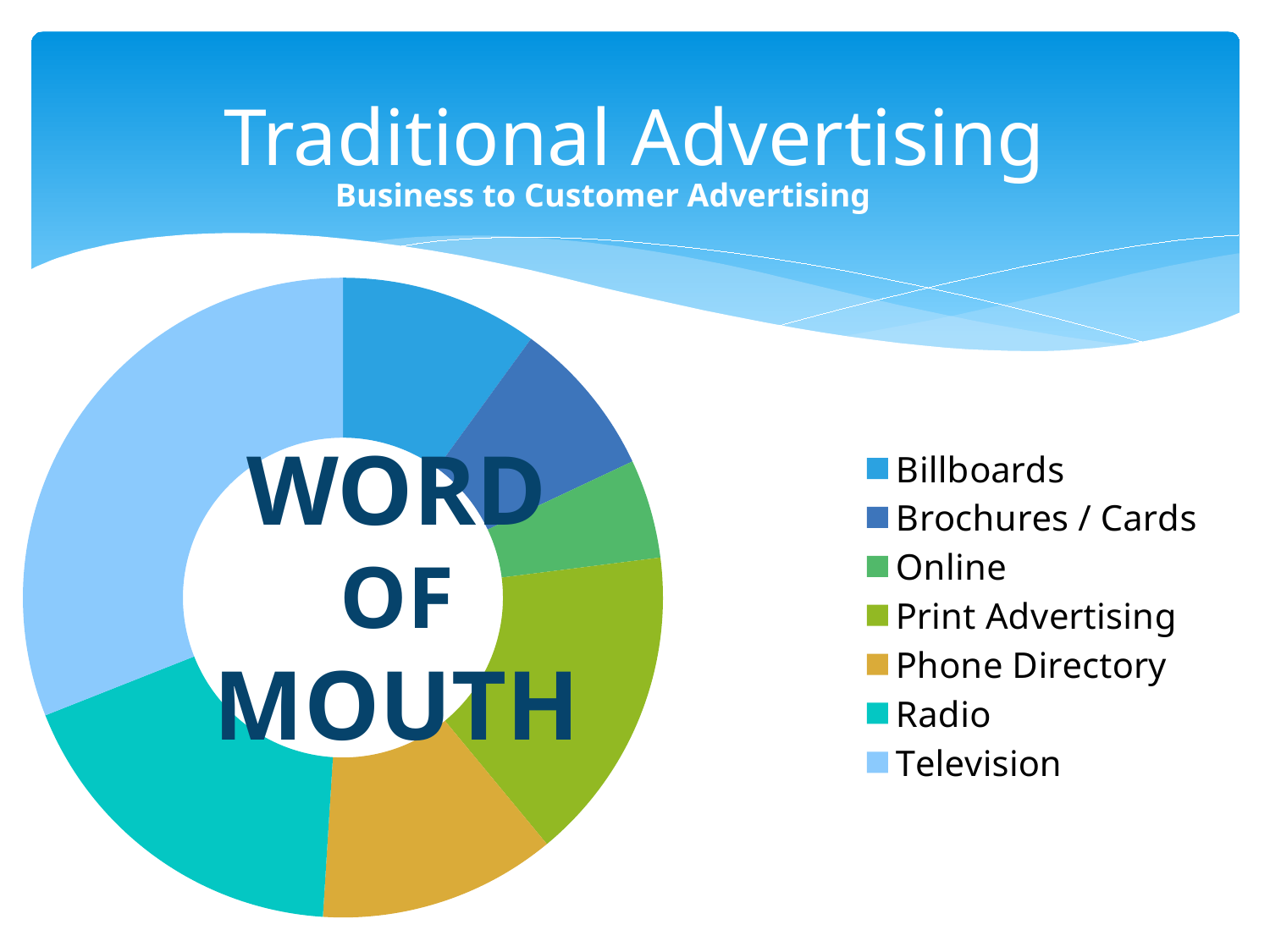
How many categories does the chart's legend list? 7 Which category has the largest slice of the chart? Television Which category has the smallest slice of the chart? Online What kind of chart is shown on the slide? doughnut chart Which slice is larger, Print Advertising or Brochures / Cards? Print Advertising Which slice is larger, Television or Billboards? Television Which slice is larger, Radio or Phone Directory? Radio What is the title of the slide containing the chart? Traditional Advertising What text is printed in the centre of the doughnut chart? WORD OF MOUTH